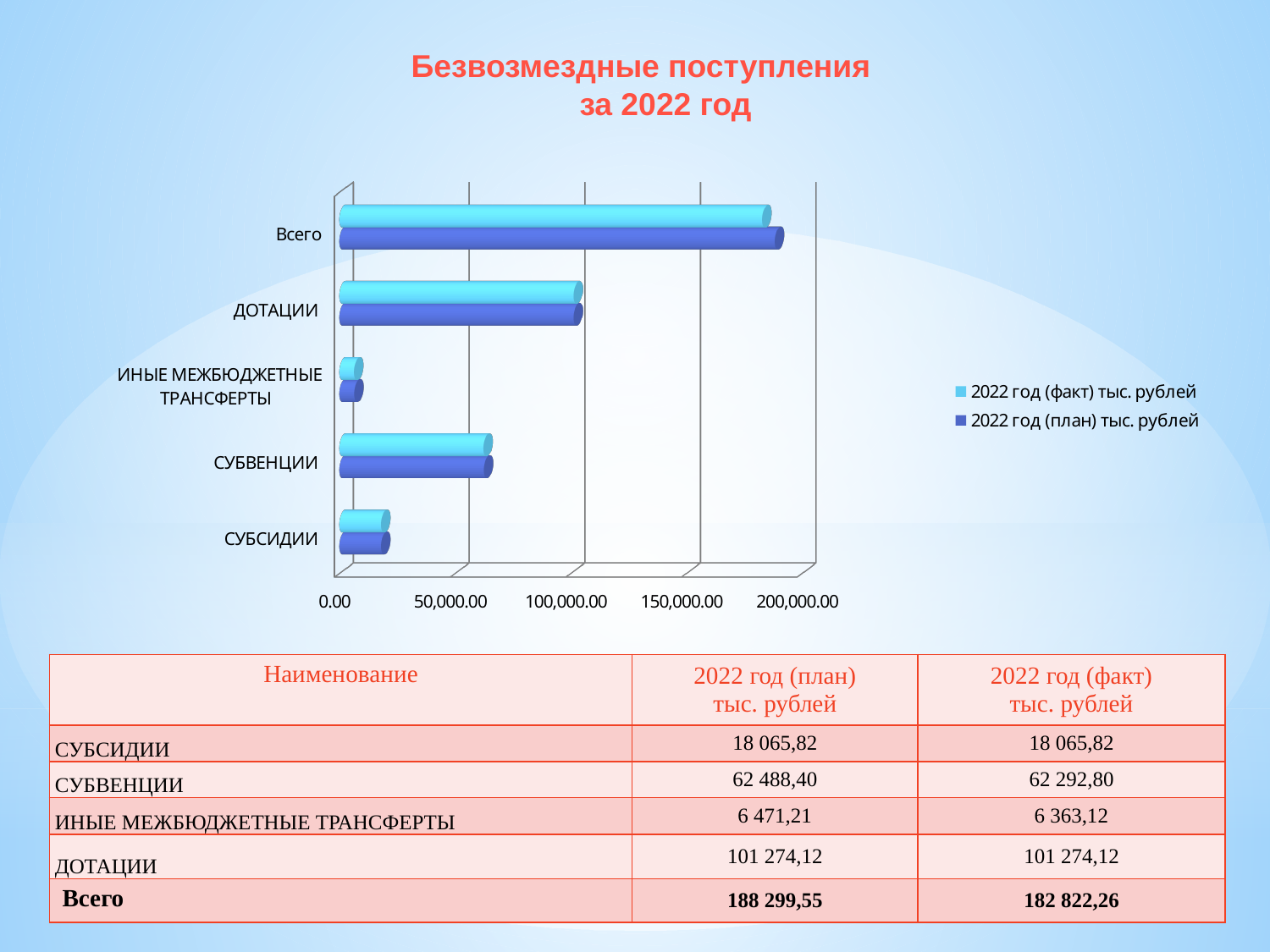
According to the table below the chart, what is the 2022 год (план) value for ДОТАЦИИ? 101 274,12 тыс. рублей Is the 2022 год (факт) value for Всего greater or less than 150,000.00? greater Excluding Всего, which category has the highest values in the chart? ДОТАЦИИ How many categories are shown on the chart's vertical axis? 5 How many series does the chart legend list? 2 What is the title of the chart? Безвозмездные поступления за 2022 год Is the 2022 год (план) value for СУБВЕНЦИИ greater or less than 50,000.00? greater Is the 2022 год (факт) value for СУБСИДИИ greater or less than 50,000.00? less Which category has the longest bars in the chart? Всего What kind of chart is shown on the slide? bar chart Which is larger in the chart, the 2022 год (план) value for СУБВЕНЦИИ or for СУБСИДИИ? СУБВЕНЦИИ Which category has the shortest bars in the chart? ИНЫЕ МЕЖБЮДЖЕТНЫЕ ТРАНСФЕРТЫ